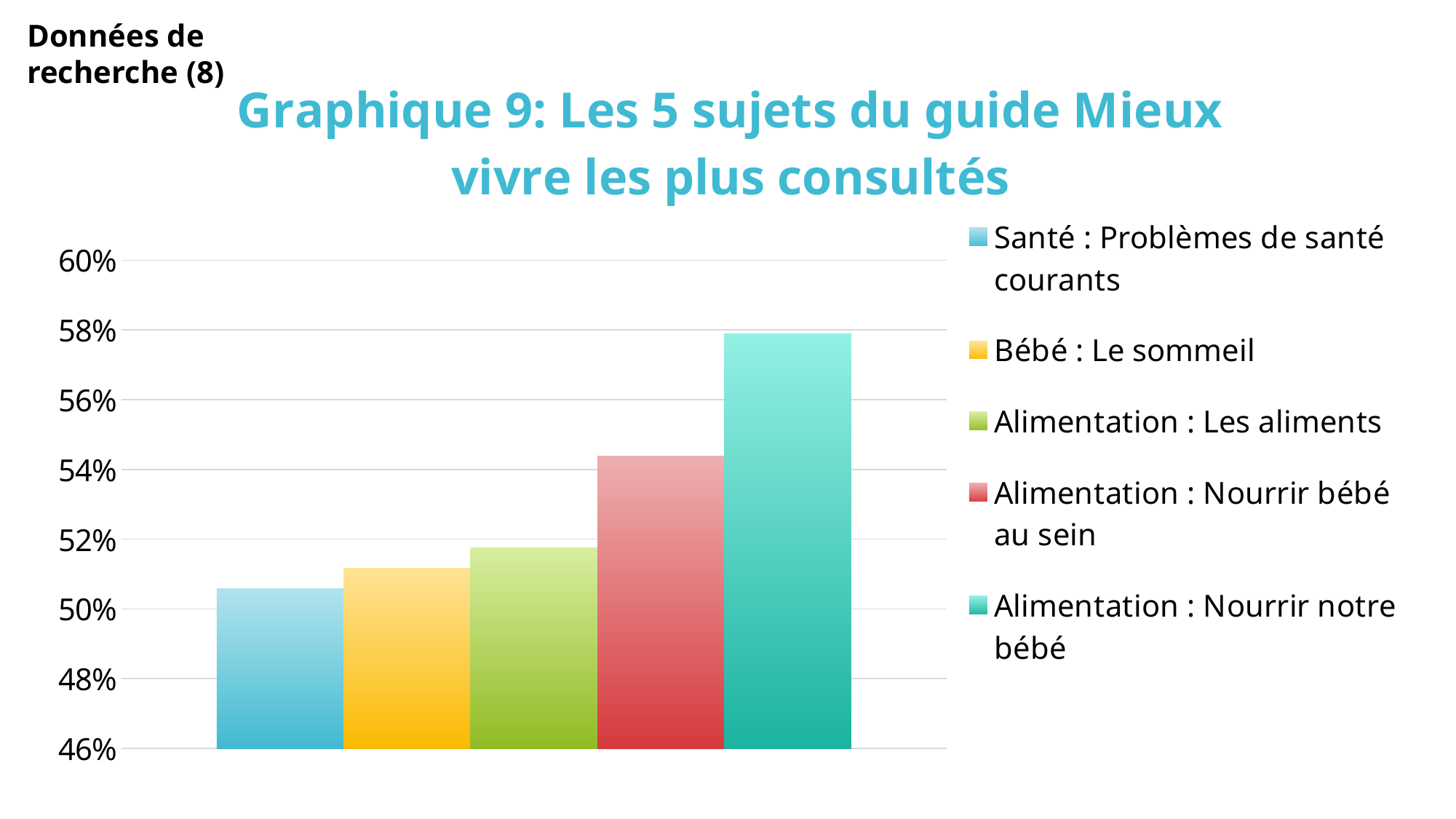
Is the value for Bébé : Le sommeil greater or less than 54%? less Which subject has the lowest value in the chart? Santé : Problèmes de santé courants What kind of chart is shown on the slide? bar chart Is the value for Alimentation : Nourrir notre bébé greater or less than 56%? greater Which is larger, the value for Alimentation : Nourrir bébé au sein or the value for Alimentation : Les aliments? Alimentation : Nourrir bébé au sein Do the bar values rise or fall from left to right across the chart? rise Which subject has the highest value in the chart? Alimentation : Nourrir notre bébé Is the value for Santé : Problèmes de santé courants greater or less than 52%? less What is the title of the chart? Graphique 9: Les 5 sujets du guide Mieux vivre les plus consultés How many entries does the legend list? 5 How many bars are plotted in the chart? 5